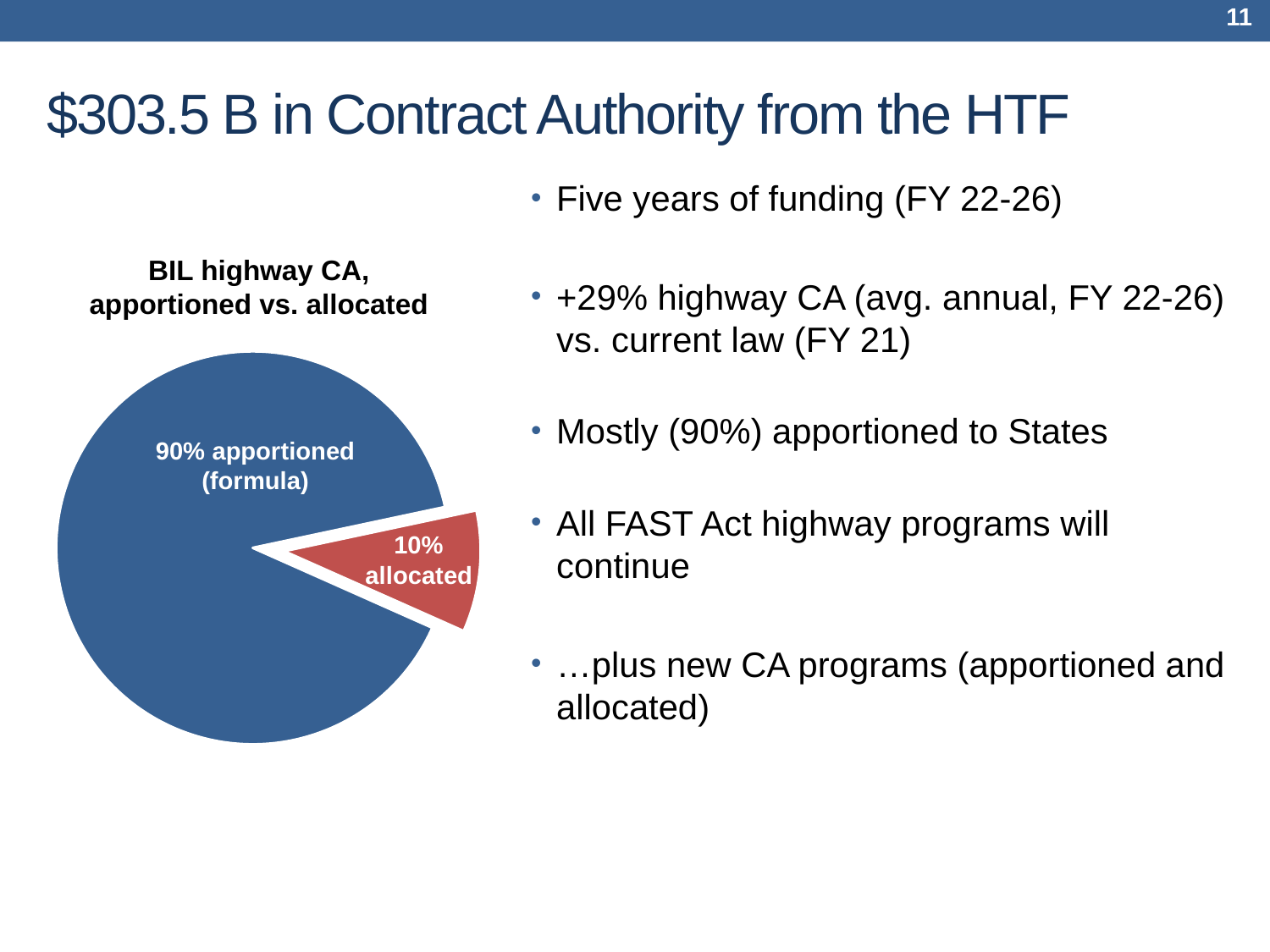
What colour is the allocated slice of the pie? red What share of the pie is allocated? 10% What share of the pie is apportioned (formula)? 90% What is the title of the chart? BIL highway CA, apportioned vs. allocated How many slices does the pie chart have? 2 Which slice of the pie is the smallest? 10% allocated Which is larger, the apportioned slice or the allocated slice? apportioned Is the share for the allocated slice greater or less than 50%? less Which slice of the pie is the largest? 90% apportioned (formula) What is the difference in percentage points between the apportioned and allocated slices? 80 percentage points What kind of chart is shown on the slide? pie chart